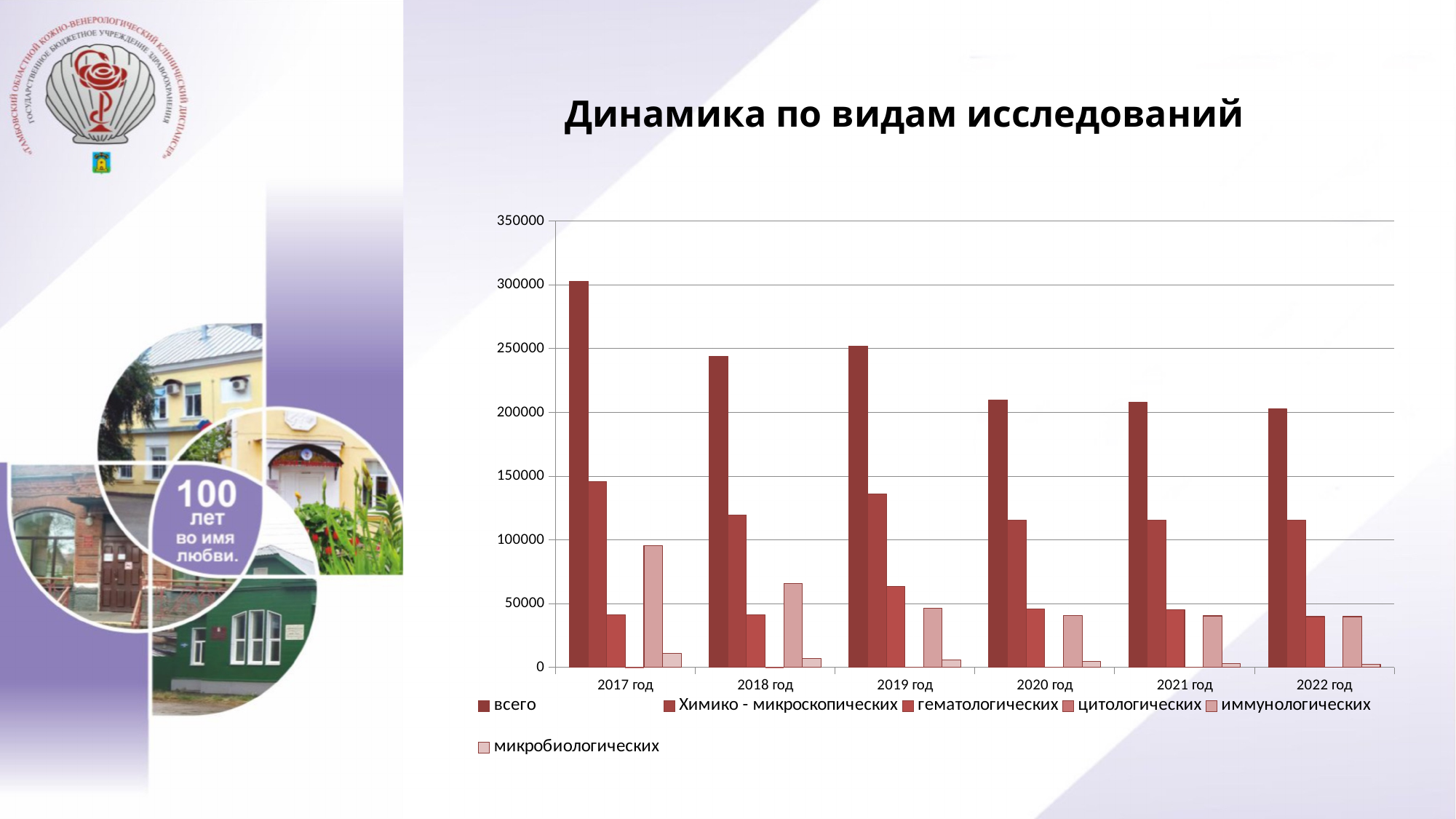
Is the value for "всего" in 2022 год greater or less than 250000? less Is the value for "иммунологических" in 2017 год greater or less than 50000? greater How many years are shown on the x axis? 6 Which is larger, the value for "Химико - микроскопических" in 2017 год or in 2018 год? 2017 год What is the title of the chart? Динамика по видам исследований In which year is the value for "иммунологических" the highest? 2017 год Is the value for "всего" in 2017 год greater or less than 250000? greater Does the value for "всего" overall rise or fall from 2017 год to 2022 год? fall In which year is the value for "всего" the highest? 2017 год What kind of chart is shown on the slide? bar chart How many series does the legend list? 6